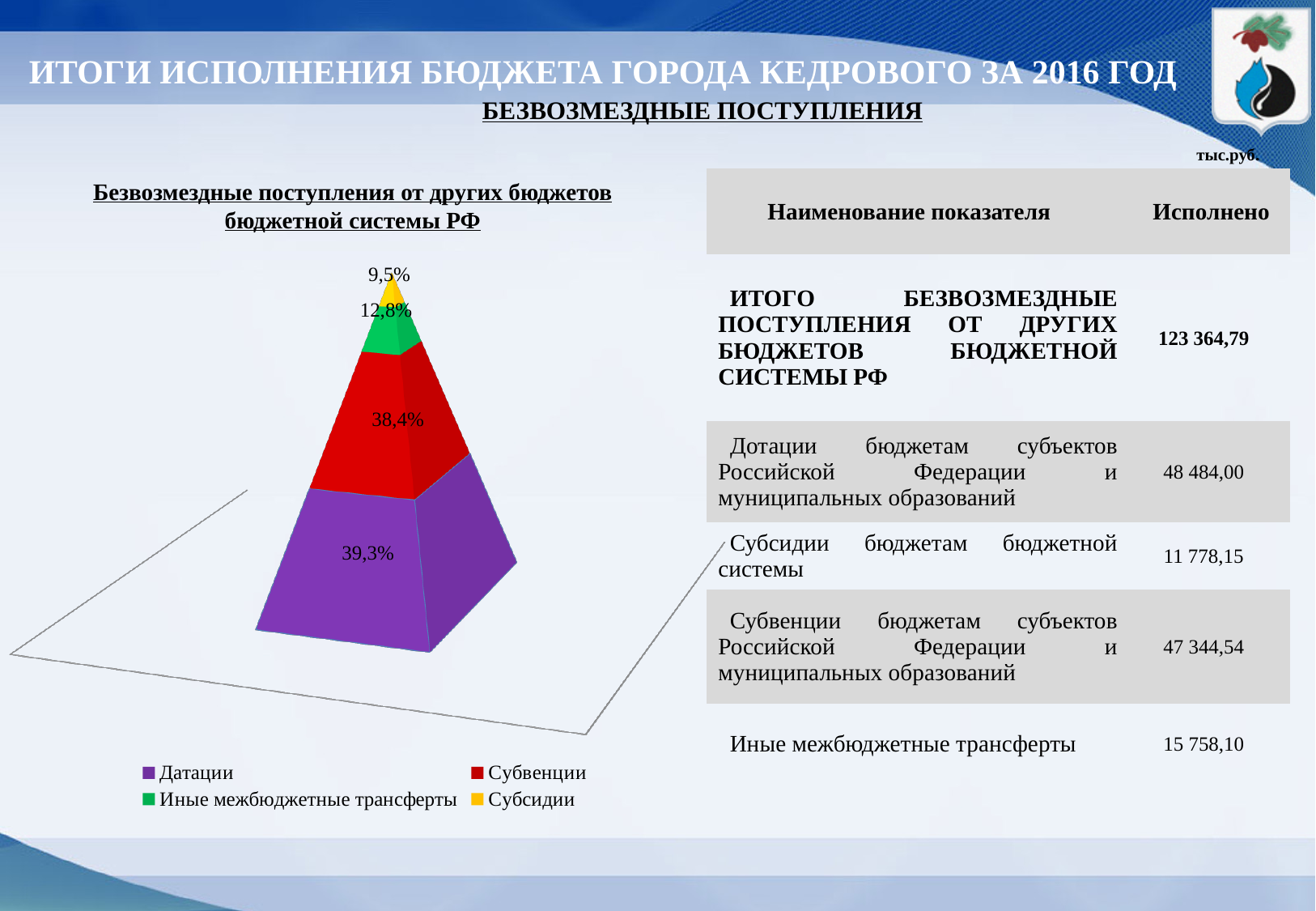
What share does Иные межбюджетные трансферты have in the pyramid chart? 12,8% What colour represents Субсидии in the pyramid chart? Yellow How many categories does the legend of the pyramid chart list? 4 What share does Субвенции have in the pyramid chart? 38,4% What share does Датации have in the chart 'Безвозмездные поступления от других бюджетов бюджетной системы РФ'? 39,3% What kind of chart is shown on the left of the slide? Pyramid chart Which category has the smallest share in the pyramid chart? Субсидии Which category has the largest share in the pyramid chart? Датации What share does Субсидии have in the pyramid chart? 9,5% Which is larger in the pyramid chart: the share of Субвенции or the share of Иные межбюджетные трансферты? Субвенции What is the difference between the shares of Датации and Субвенции in the pyramid chart? 0,9% What is the difference between the shares of Иные межбюджетные трансферты and Субсидии in the pyramid chart? 3,3%